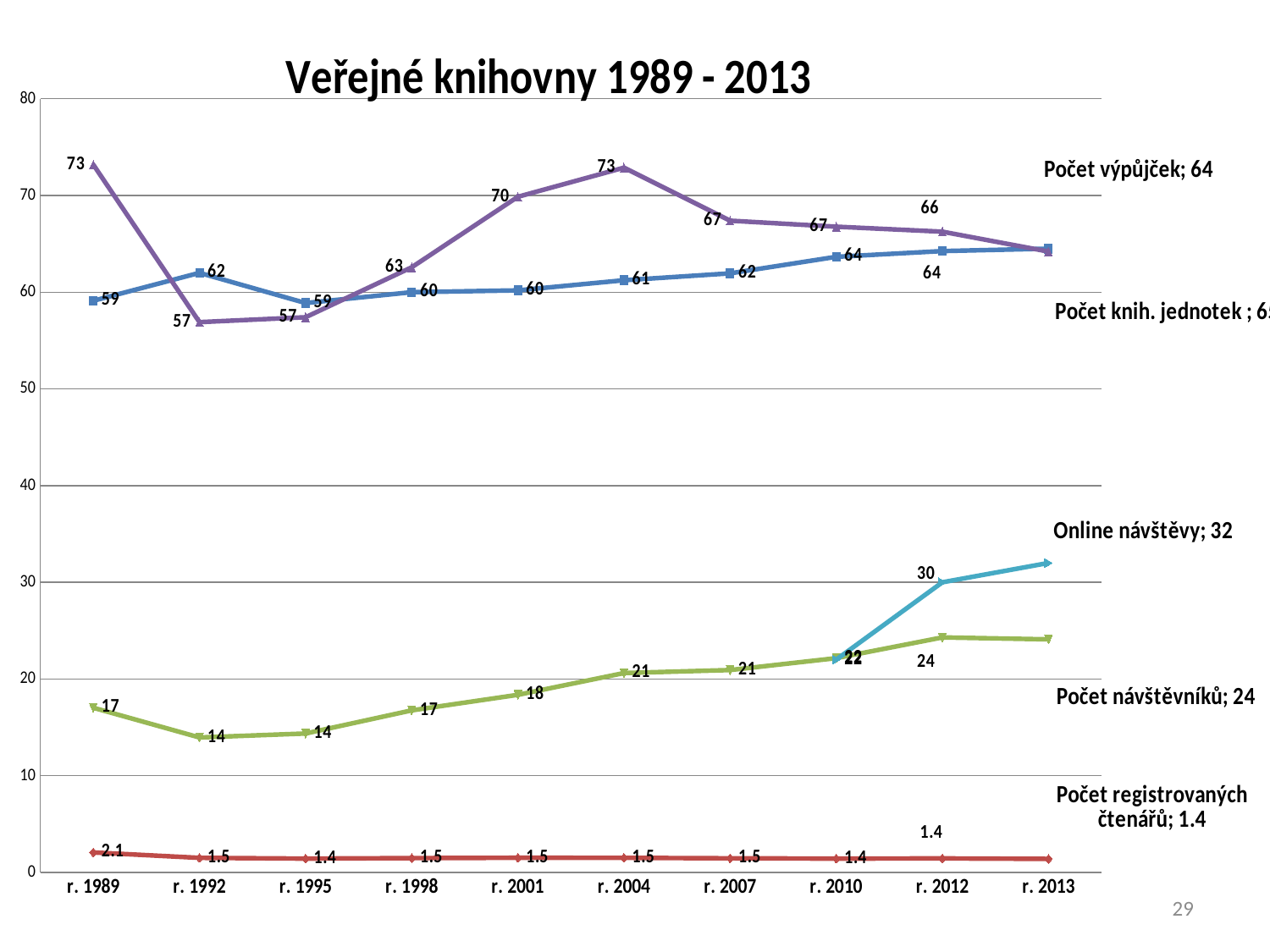
In r. 1992, which is larger: Počet výpůjček or Počet knih. jednotek? Počet knih. jednotek What is the value of Online návštěvy in r. 2012? 30 What is the value of Počet návštěvníků in r. 1992? 14 How many data series are plotted on the chart? 5 Is the value of Počet výpůjček in r. 2001 greater or less than 60? greater What is the difference between Počet výpůjček in r. 1989 and in r. 2013? 9 What is the value of Počet registrovaných čtenářů in r. 1989? 2.1 How many years are shown on the x axis of the chart? 10 In which year is Online návštěvy highest? r. 2013 What is the value of Počet výpůjček in r. 2004? 73 What kind of chart is shown on the slide? line chart What is the title of the chart? Veřejné knihovny 1989 - 2013